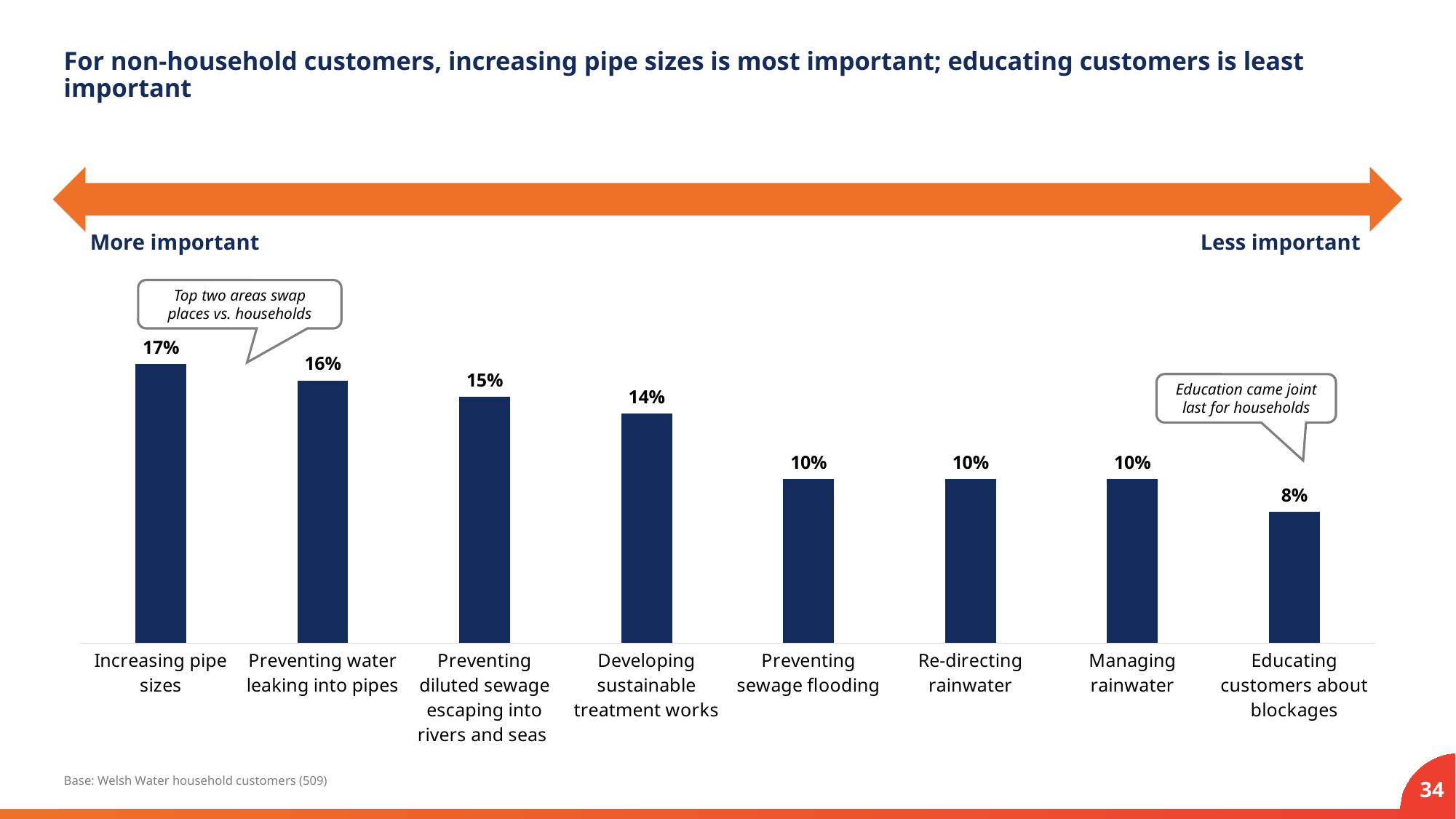
What is the value for Increasing pipe sizes? 17% Which category has the highest value? Increasing pipe sizes How many categories are shown in the chart? 8 What is the value for Developing sustainable treatment works? 14% What is the difference between the values for Increasing pipe sizes and Educating customers about blockages? 9% What is the value for Preventing water leaking into pipes? 16% Do the values rise or fall from left to right along the x axis? Fall What is the difference between the values for Preventing diluted sewage escaping into rivers and seas and Preventing sewage flooding? 5% Which category has the lowest value? Educating customers about blockages What kind of chart is shown on the slide? Bar chart Which is larger, the value for Developing sustainable treatment works or the value for Managing rainwater? Developing sustainable treatment works What is the value for Educating customers about blockages? 8%